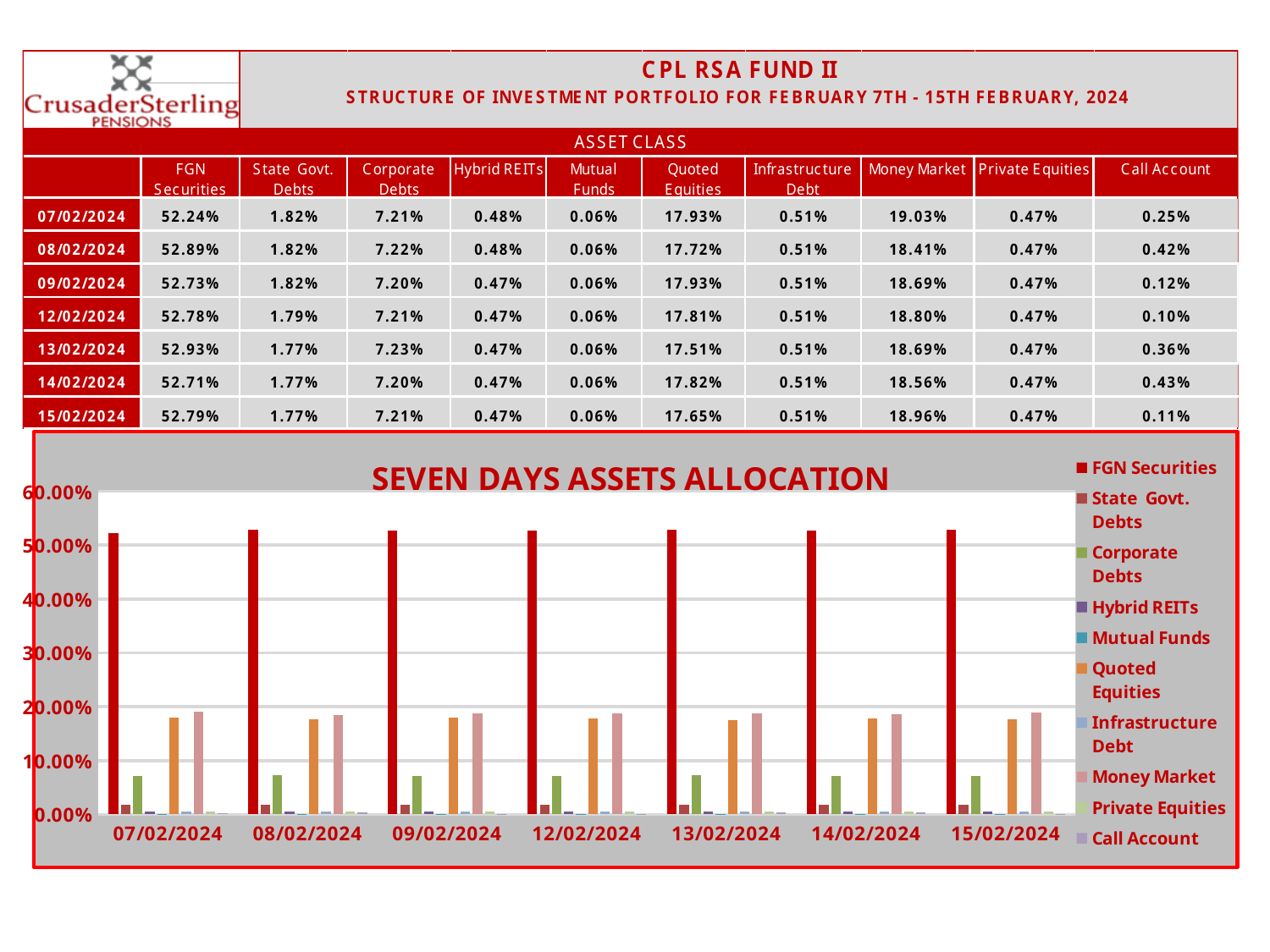
On 14/02/2024, which is larger: Quoted Equities or Money Market? Money Market What kind of chart is shown under the title SEVEN DAYS ASSETS ALLOCATION? bar chart What is the title of the chart on the slide? SEVEN DAYS ASSETS ALLOCATION Which asset class has the highest allocation on 07/02/2024 in the SEVEN DAYS ASSETS ALLOCATION chart? FGN Securities What is the Money Market allocation on 08/02/2024? 18.41% How many dates are shown along the x axis of the SEVEN DAYS ASSETS ALLOCATION chart? 7 Which asset class has the lowest allocation on 15/02/2024? Mutual Funds Is the value for FGN Securities on 07/02/2024 greater or less than 50.00%? greater Is the value for Money Market on 15/02/2024 greater or less than 20.00%? less What is the difference between the Money Market and Quoted Equities allocations on 07/02/2024? 1.10% What is the FGN Securities allocation on 13/02/2024? 52.93% How many series does the legend of the SEVEN DAYS ASSETS ALLOCATION chart list? 10